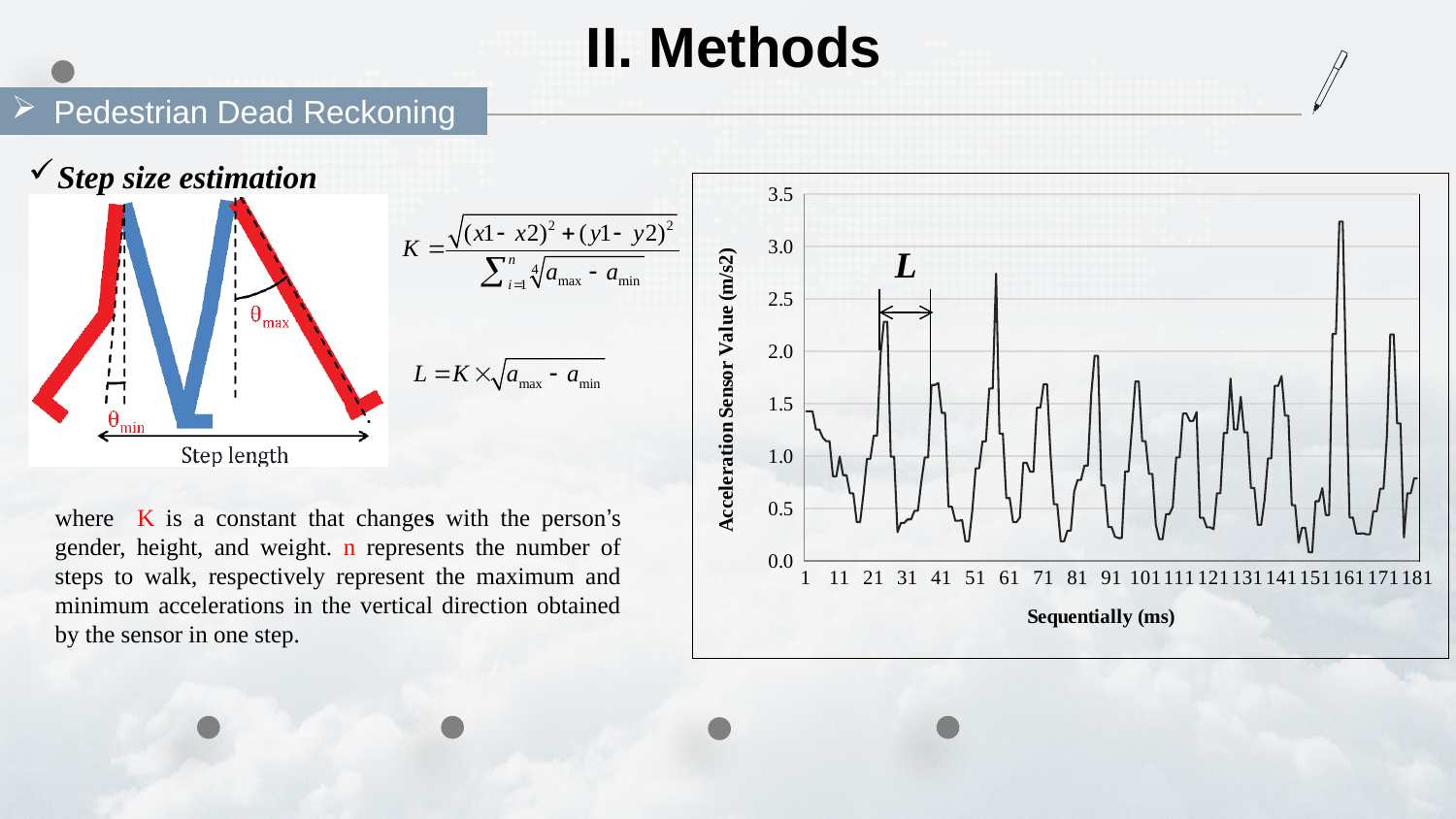
Is the peak of the line near x = 61 greater or less than 2.5? greater What is the title of the horizontal axis of the chart? Sequentially (ms) What is the last tick label on the horizontal axis of the chart? 181 What letter labels the arrow annotation between two peaks in the chart? L What is the title of the vertical axis of the chart? Acceleration Sensor Value (m/s2) What is the first tick label on the horizontal axis of the chart? 1 Is the lowest point of the line in the chart greater or less than 0.5? less What is the highest value shown on the vertical axis of the chart? 3.5 What kind of chart is shown on the slide? line chart Is the value of the line at x = 1 greater or less than 1.0? greater How many lines are plotted in the chart? 1